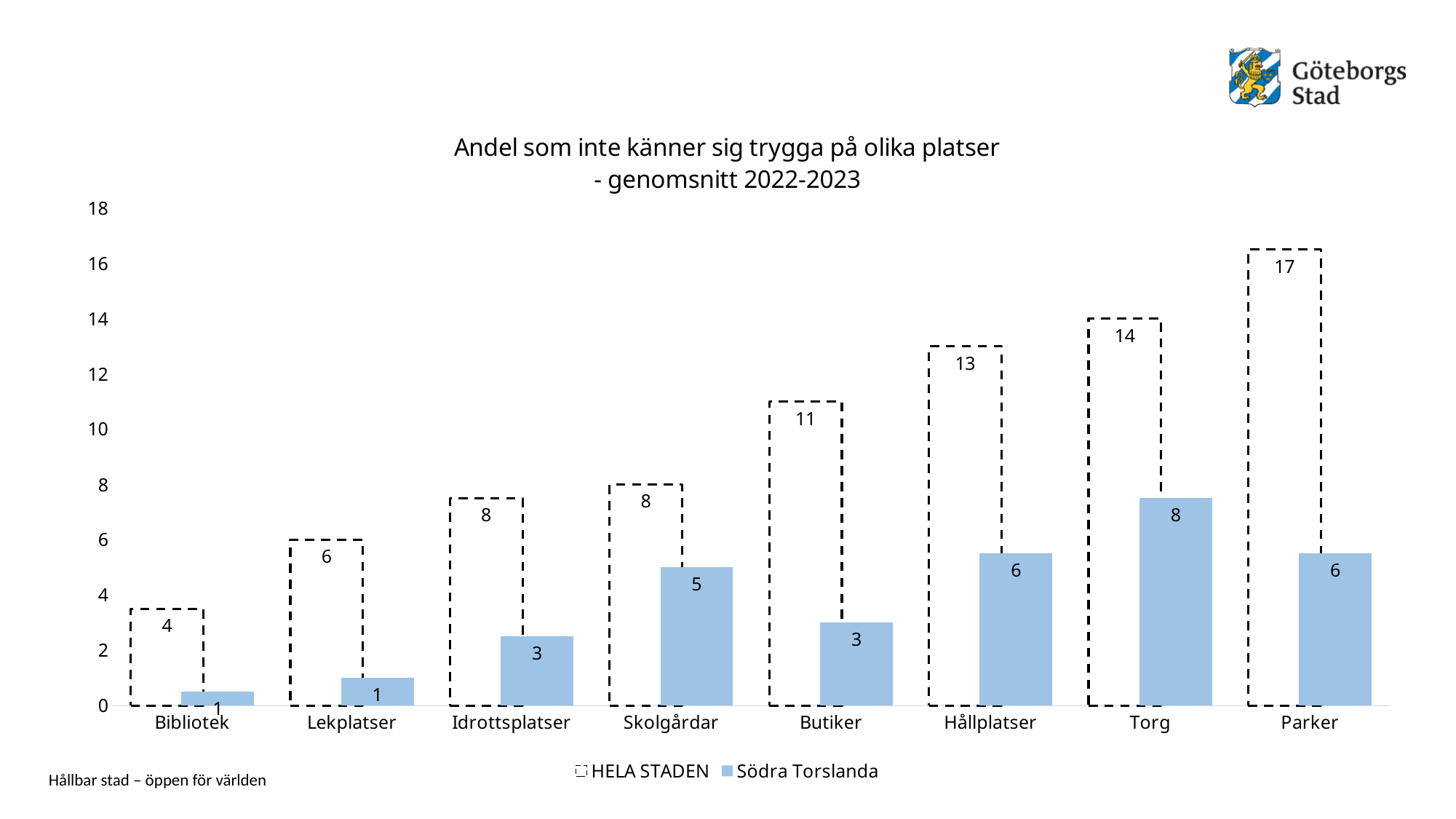
What is the value for HELA STADEN at Butiker? 11 Which is larger at Hållplatser: HELA STADEN or Södra Torslanda? HELA STADEN What is the value for Södra Torslanda at Bibliotek? 1 Which category has the lowest value for Södra Torslanda? Bibliotek and Lekplatser (both 1) What is the difference between HELA STADEN and Södra Torslanda at Parker? 11 How many series does the legend list? 2 Which category has the highest value for HELA STADEN? Parker How many categories are shown on the x axis? 8 What is the value for HELA STADEN at Parker? 17 What is the title of the chart? Andel som inte känner sig trygga på olika platser - genomsnitt 2022-2023 What is the value for Södra Torslanda at Torg? 8 What kind of chart is shown on the slide? Bar chart